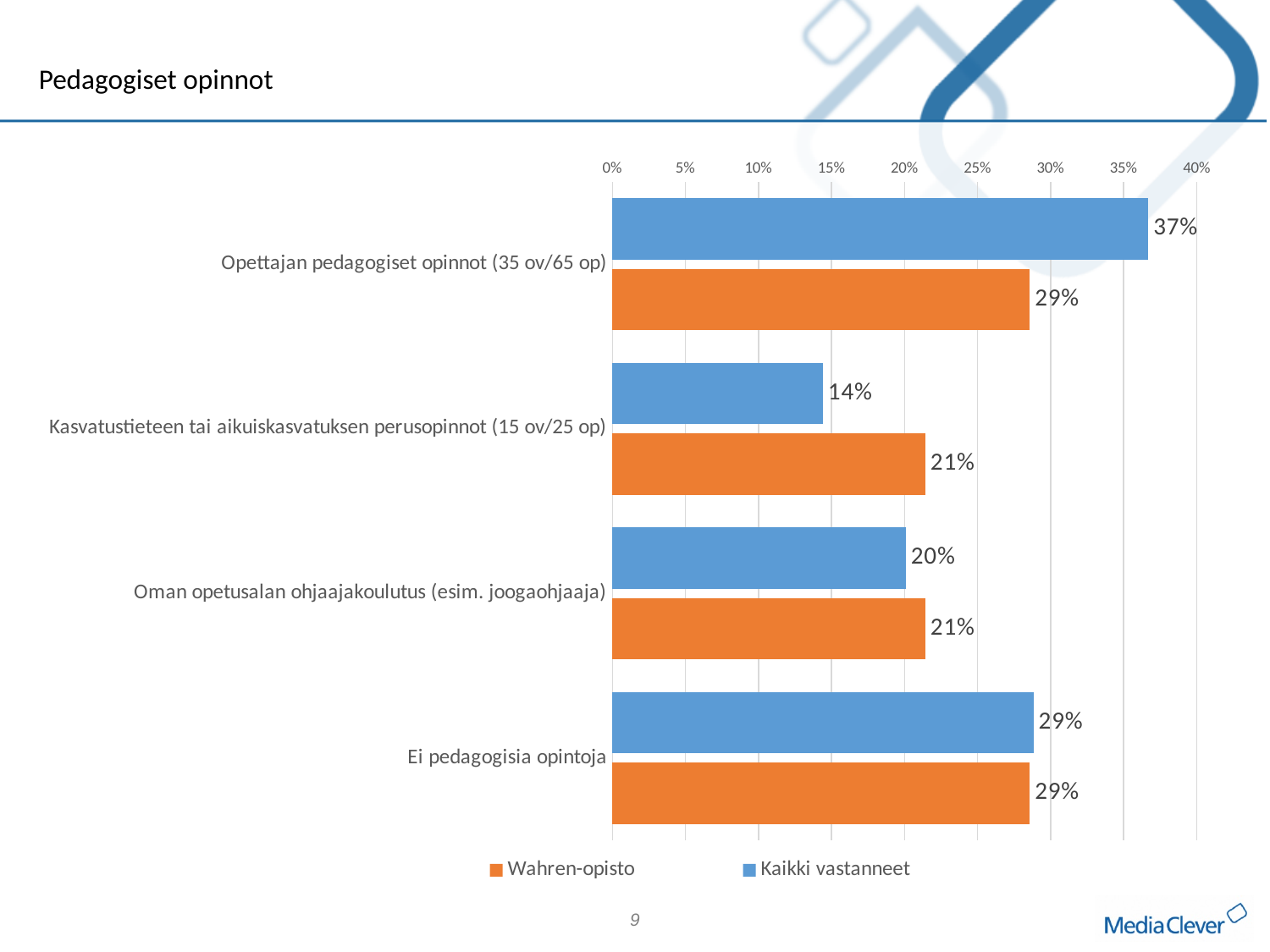
For Kasvatustieteen tai aikuiskasvatuksen perusopinnot (15 ov/25 op), which series has the larger value, Wahren-opisto or Kaikki vastanneet? Wahren-opisto What is the value for Kaikki vastanneet for Oman opetusalan ohjaajakoulutus (esim. joogaohjaaja)? 20% Which category has the highest value for Kaikki vastanneet? Opettajan pedagogiset opinnot (35 ov/65 op) What is the value for Wahren-opisto for Ei pedagogisia opintoja? 29% What is the value for Wahren-opisto for Kasvatustieteen tai aikuiskasvatuksen perusopinnot (15 ov/25 op)? 21% What kind of chart is shown on the slide? Bar chart What is the value for Kaikki vastanneet for Opettajan pedagogiset opinnot (35 ov/65 op)? 37% How many series does the legend list? 2 What is the difference between Kaikki vastanneet and Wahren-opisto for Opettajan pedagogiset opinnot (35 ov/65 op)? 8% Which colour represents Wahren-opisto in the chart? Orange Which category has the lowest value for Kaikki vastanneet? Kasvatustieteen tai aikuiskasvatuksen perusopinnot (15 ov/25 op) How many categories are shown in the chart? 4